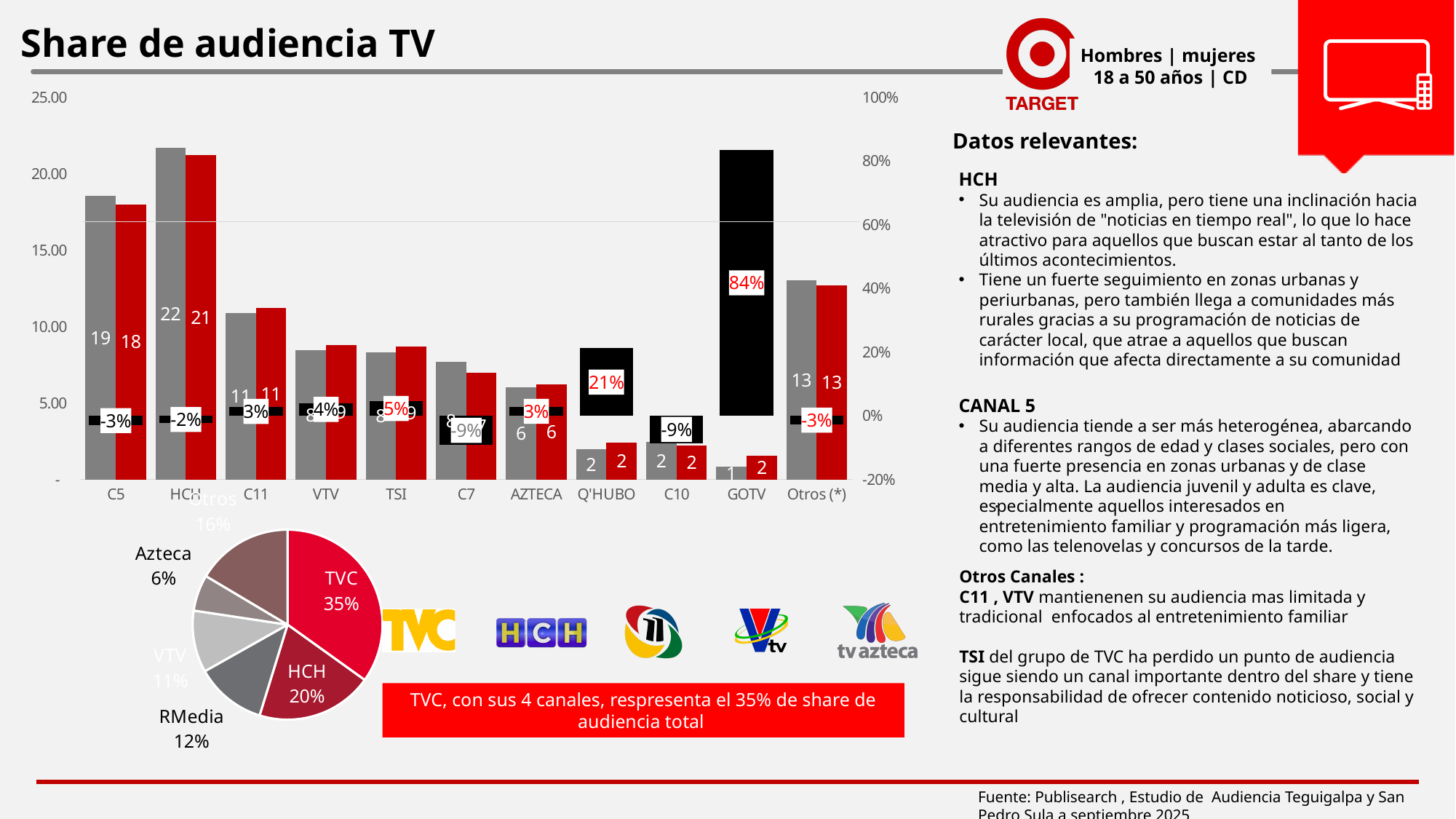
In the bar chart, what percentage change label is shown for Q'HUBO? 21% In the pie chart, which slice is the smallest? Azteca In the bar chart, which channel has the highest grey bar? HCH In the bar chart, what is the value of the grey bar for C5? 19 In the bar chart, what is the difference between the grey bar and the red bar for C5? 1 How many channel categories are shown on the x axis of the bar chart? 11 In the bar chart, which channel has the lowest grey bar? GOTV In the bar chart, which red bar is larger, VTV or C7? VTV In the bar chart, what percentage change label is shown for GOTV? 84% In the bar chart, what is the value of the red bar for HCH? 21 In the pie chart, what share does TVC have? 35% How many slices does the pie chart have? 6